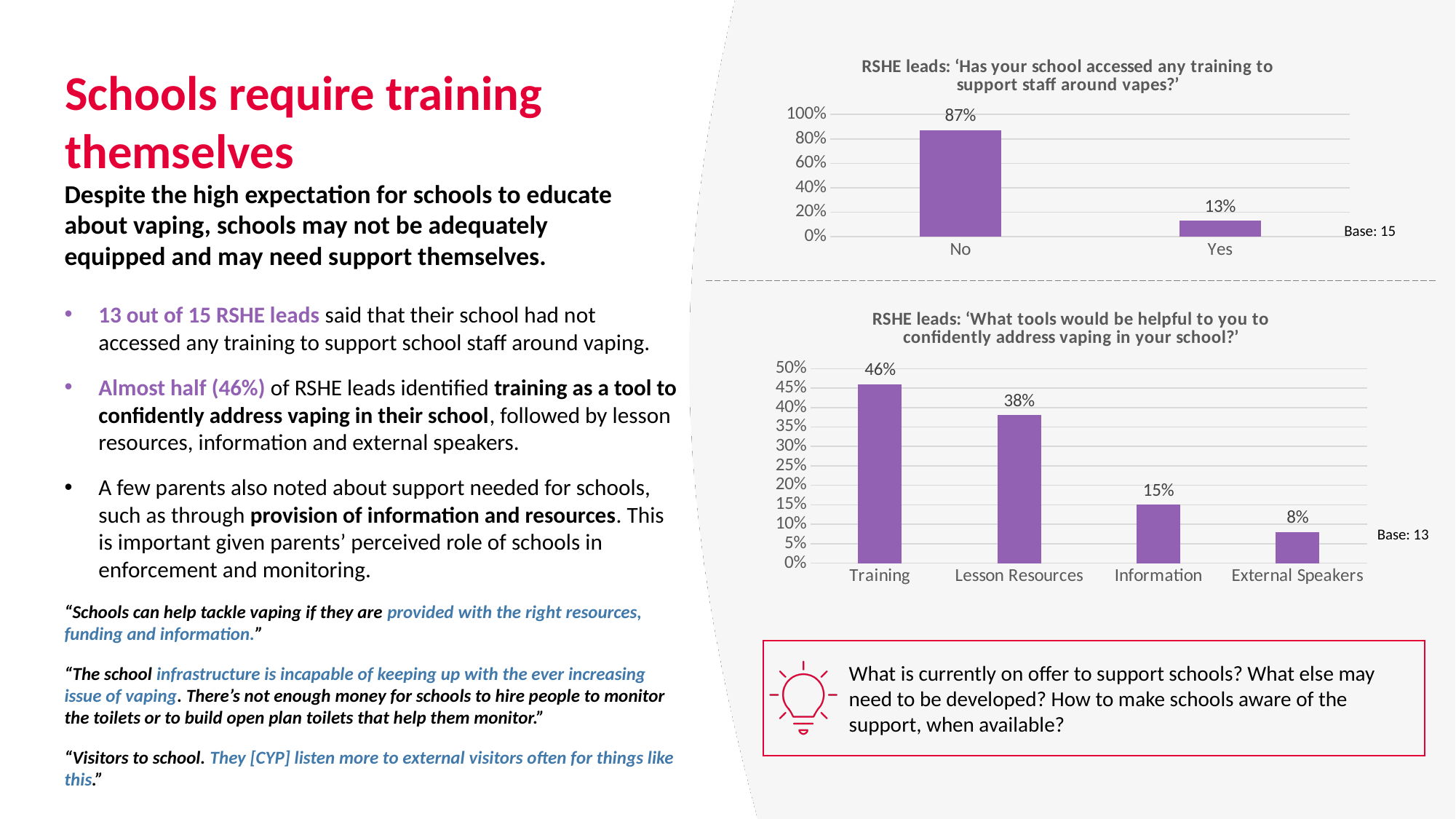
In the top chart ('Has your school accessed any training to support staff around vapes?'), what percentage of RSHE leads answered 'Yes'? 13% In the bottom chart ('What tools would be helpful to you to confidently address vaping in your school?'), which tool has the highest percentage? Training What type of chart is the bottom chart ('What tools would be helpful to you to confidently address vaping in your school?')? Bar chart In the top chart ('Has your school accessed any training to support staff around vapes?'), how many categories are shown on the x axis? 2 In the bottom chart ('What tools would be helpful to you to confidently address vaping in your school?'), what percentage of RSHE leads identified Training? 46% In the bottom chart ('What tools would be helpful to you to confidently address vaping in your school?'), which tool has the lowest percentage? External Speakers In the top chart ('Has your school accessed any training to support staff around vapes?'), what is the difference between the 'No' and 'Yes' percentages? 74% In the top chart ('Has your school accessed any training to support staff around vapes?'), what is the base (number of respondents) shown? Base: 15 In the top chart ('Has your school accessed any training to support staff around vapes?'), what percentage of RSHE leads answered 'No'? 87% In the bottom chart ('What tools would be helpful to you to confidently address vaping in your school?'), what percentage of RSHE leads identified Lesson Resources? 38% In the bottom chart ('What tools would be helpful to you to confidently address vaping in your school?'), what is the difference between the percentages for Information and External Speakers? 7% In the bottom chart ('What tools would be helpful to you to confidently address vaping in your school?'), do the values rise or fall from left to right along the x axis? Fall